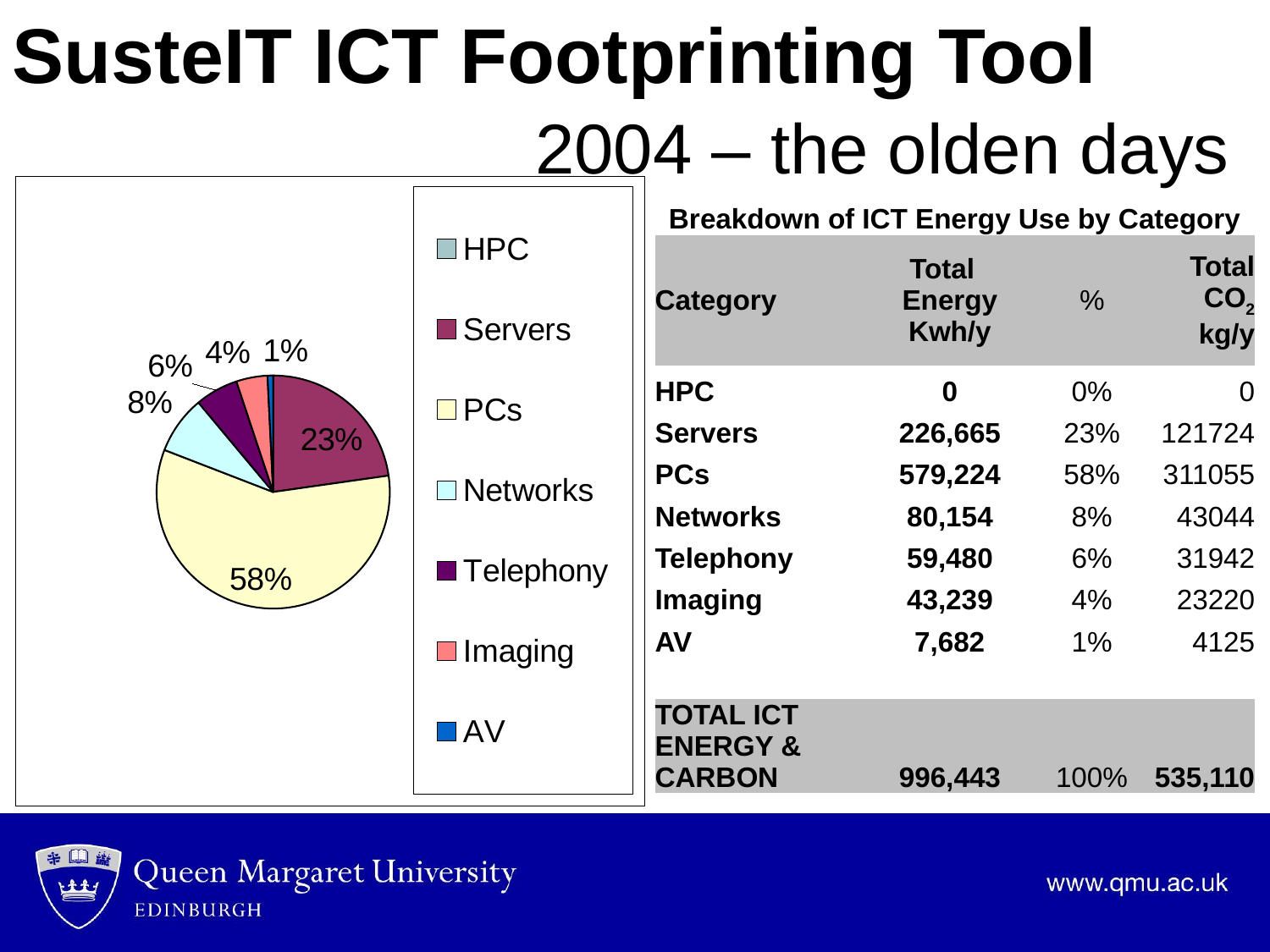
What share of the pie does Imaging account for? 4% How many categories does the legend of the pie chart list? 7 What share of the pie does Telephony account for? 6% What kind of chart is shown on the slide? pie chart Which slice is larger, Networks or Telephony? Networks Which of the labelled slices is the smallest in the pie chart? AV What share of the pie does PCs account for? 58% Which category has the largest slice of the pie? PCs What is the difference in percentage points between the PCs slice and the Servers slice? 35%